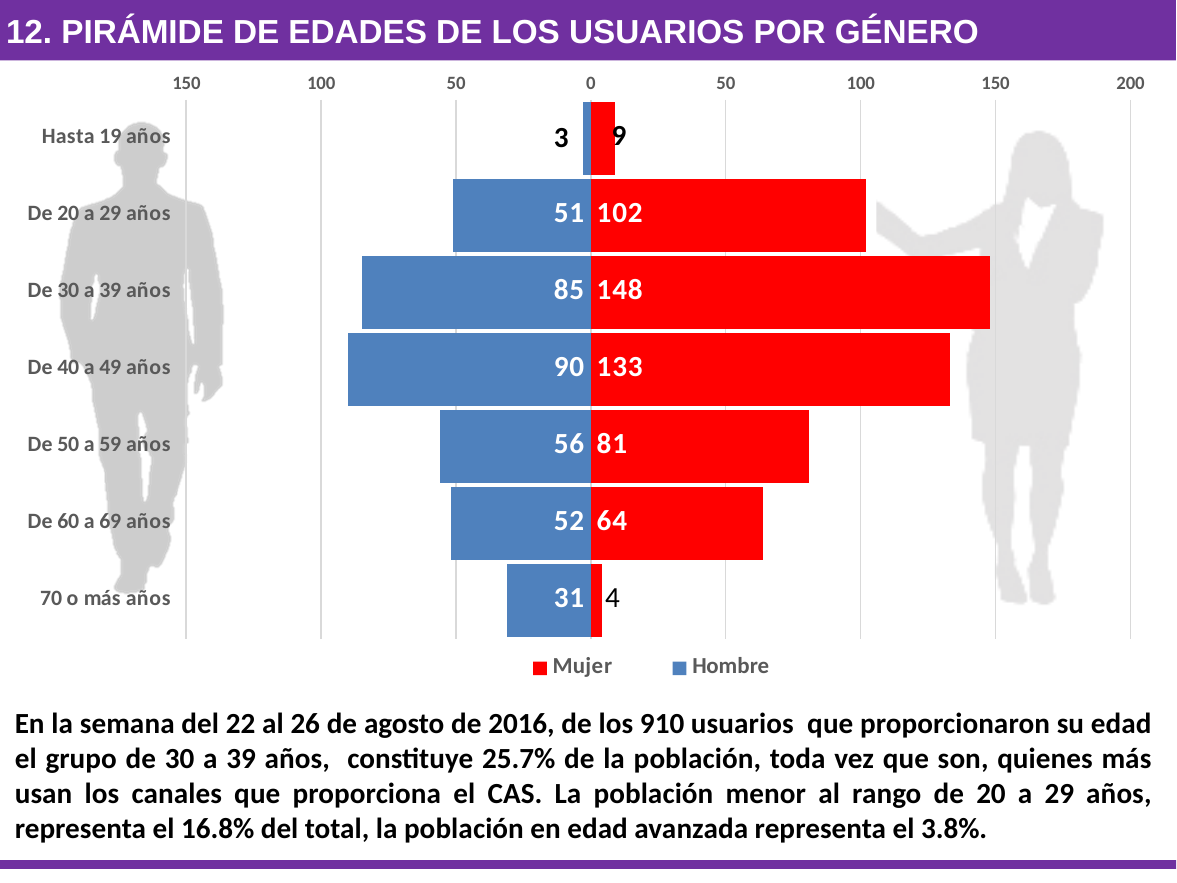
What is the value for Hombre in the 'De 40 a 49 años' category? 90 What is the combined total of Mujer and Hombre in the 'De 50 a 59 años' category? 137 Which colour represents the Hombre series in the chart? Blue What is the value for Mujer in the 'De 30 a 39 años' category? 148 Which age category has the highest value for Mujer? De 30 a 39 años Which is larger in the 'De 60 a 69 años' category, the Mujer value or the Hombre value? Mujer What kind of chart is shown on the slide? Bar chart How many series does the legend list? 2 Which age category has the lowest value for Hombre? Hasta 19 años What is the difference between the Mujer and Hombre values in the 'De 20 a 29 años' category? 51 How many age categories are shown in the chart? 7 What is the value for Mujer in the '70 o más años' category? 4